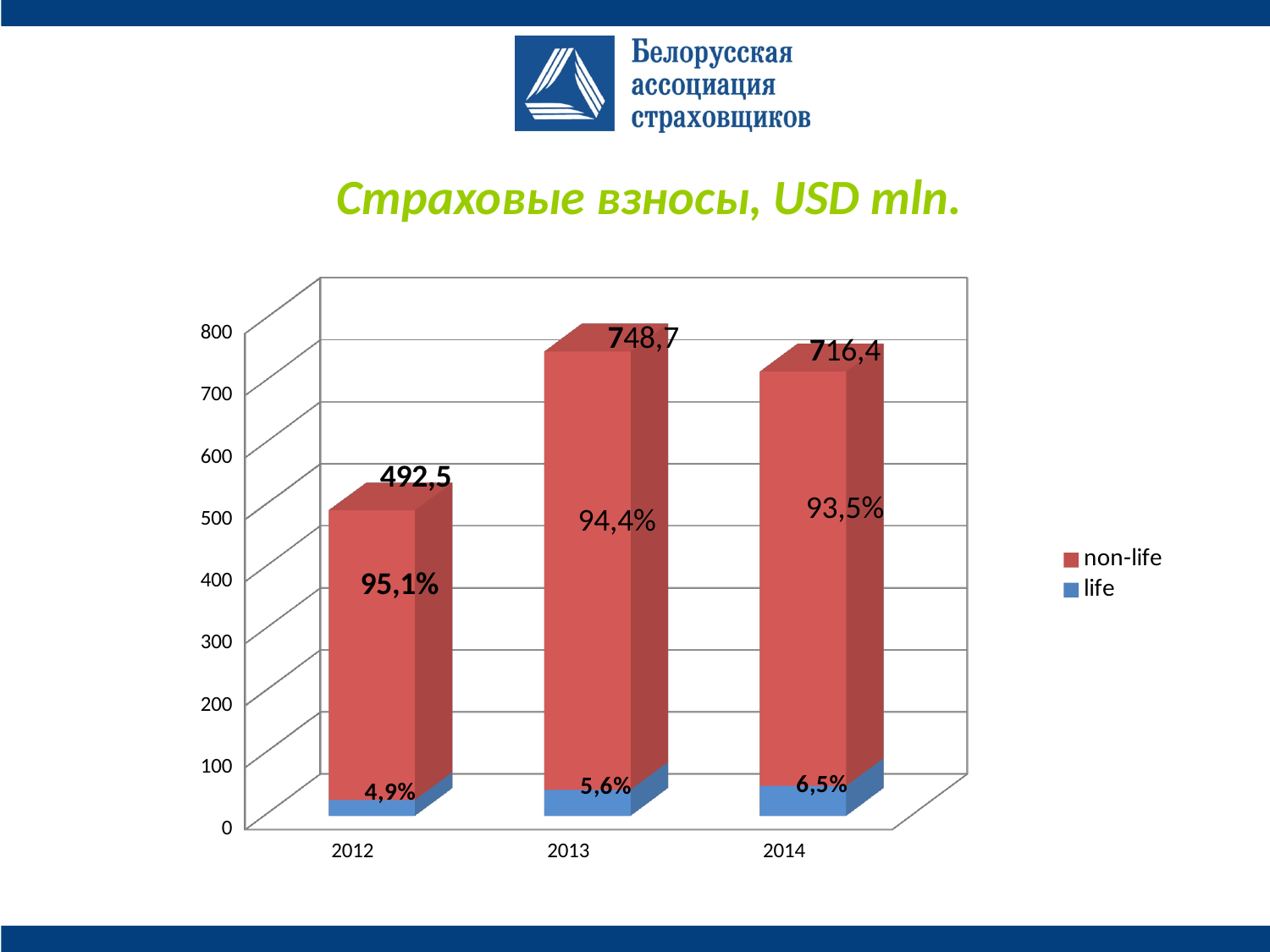
What kind of chart is shown on the slide? Stacked bar chart What percentage share does the non-life segment have in 2012? 95,1% What is the difference between the total for 2013 and the total for 2012? 256,2 What percentage share does the life segment have in 2014? 6,5% How many series does the legend list? 2 Which year has the highest total insurance premiums? 2013 How many years are shown on the x axis? 3 What is the total value labelled on the 2012 bar? 492,5 Which year has the lowest total insurance premiums? 2012 What is the difference between the total for 2013 and the total for 2014? 32,3 Which year has a larger life share: 2012 or 2014? 2014 What is the total insurance premium value shown for 2013? 748,7